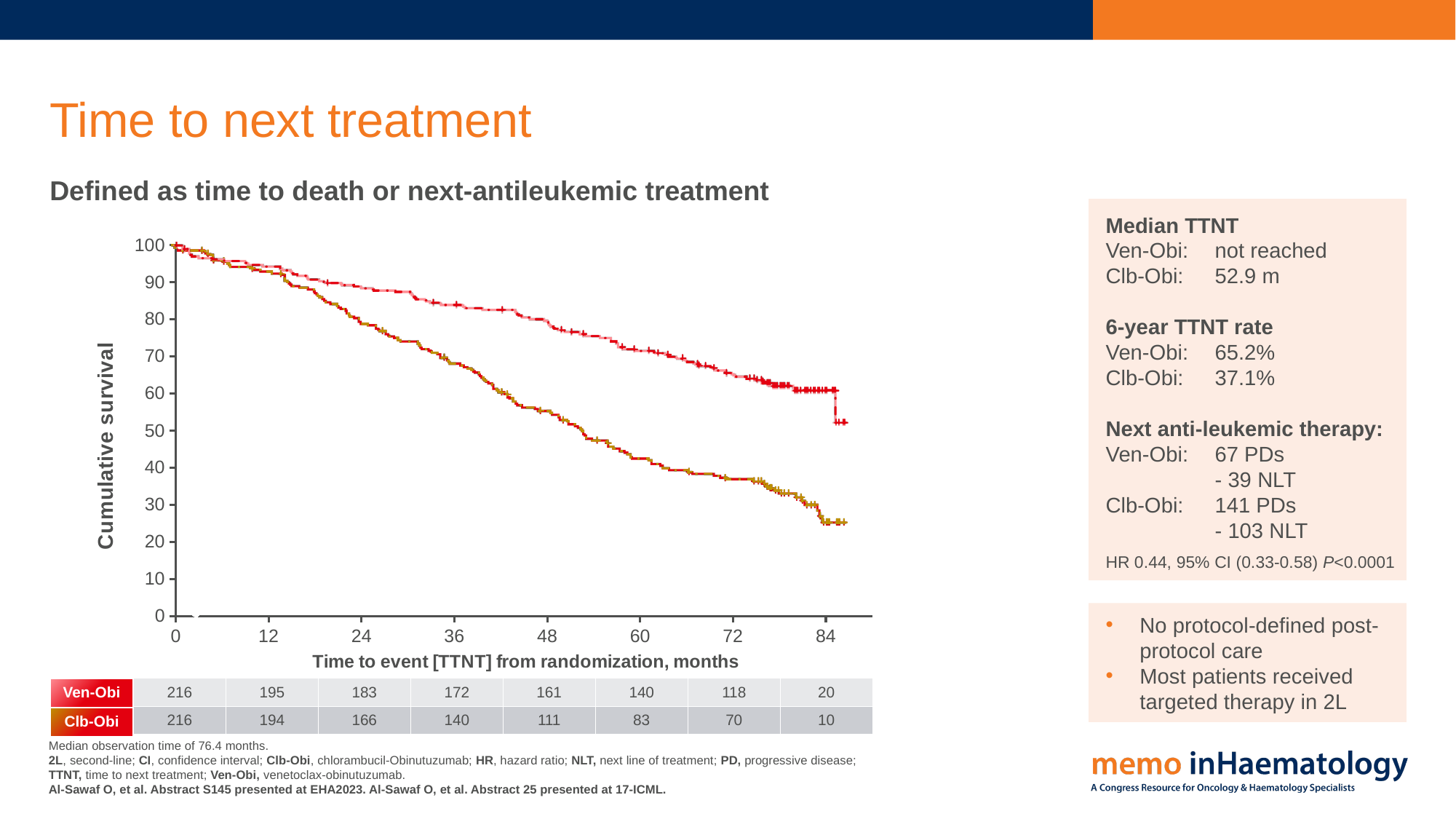
What is the difference between the Ven-Obi and Clb-Obi numbers at risk at 36 months? 32 According to the number-at-risk table, how many Clb-Obi patients were at risk at 60 months? 83 What is the label of the x axis of the chart? Time to event [TTNT] from randomization, months What kind of chart is shown on the slide? Line chart (Kaplan-Meier survival curve) How many time points are listed in the number-at-risk table for each arm? 8 Is the cumulative survival for the Ven-Obi curve at 72 months greater or less than 60? greater According to the number-at-risk table, how many Ven-Obi patients were at risk at 48 months? 161 Is the cumulative survival for the Clb-Obi curve at 48 months greater or less than 60? less How many series (treatment arms) are plotted in the chart? 2 Do the cumulative survival curves rise or fall as time from randomization increases? fall What is the label of the y axis of the chart? Cumulative survival At 72 months, which arm has more patients at risk, Ven-Obi or Clb-Obi? Ven-Obi